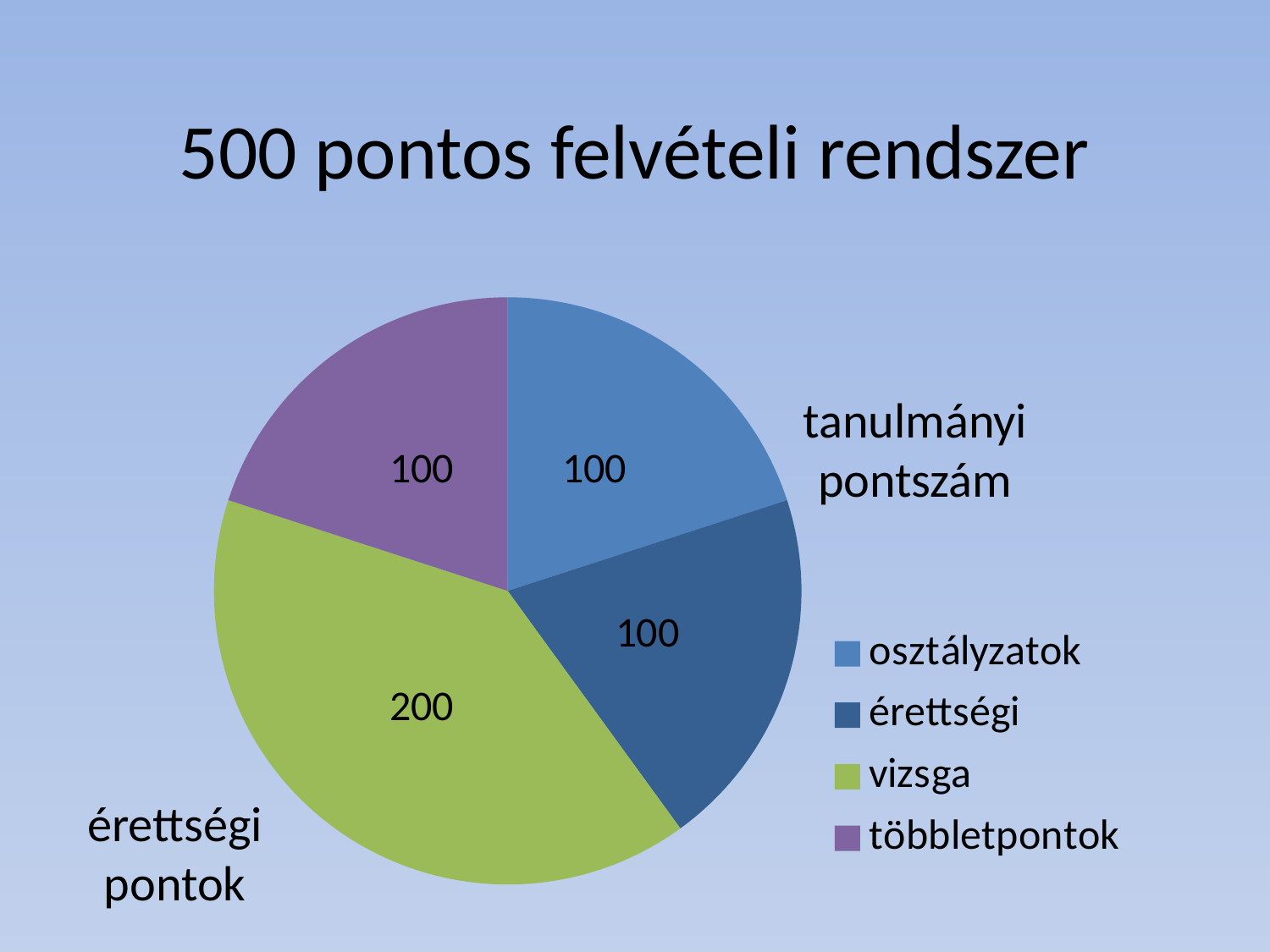
What kind of chart is shown on the slide? pie chart What is the value of the vizsga slice? 200 Which is larger, the vizsga slice or the osztályzatok slice? vizsga What is the difference between the vizsga value and the érettségi value? 100 How many entries does the legend list? 4 What share of the pie does the vizsga slice represent? 40% How many slices does the pie chart have? 4 What is the value of the osztályzatok slice? 100 What share of the pie does the többletpontok slice represent? 20% Which category has the largest slice of the pie? vizsga What is the title of the slide? 500 pontos felvételi rendszer What is the value of the többletpontok slice? 100